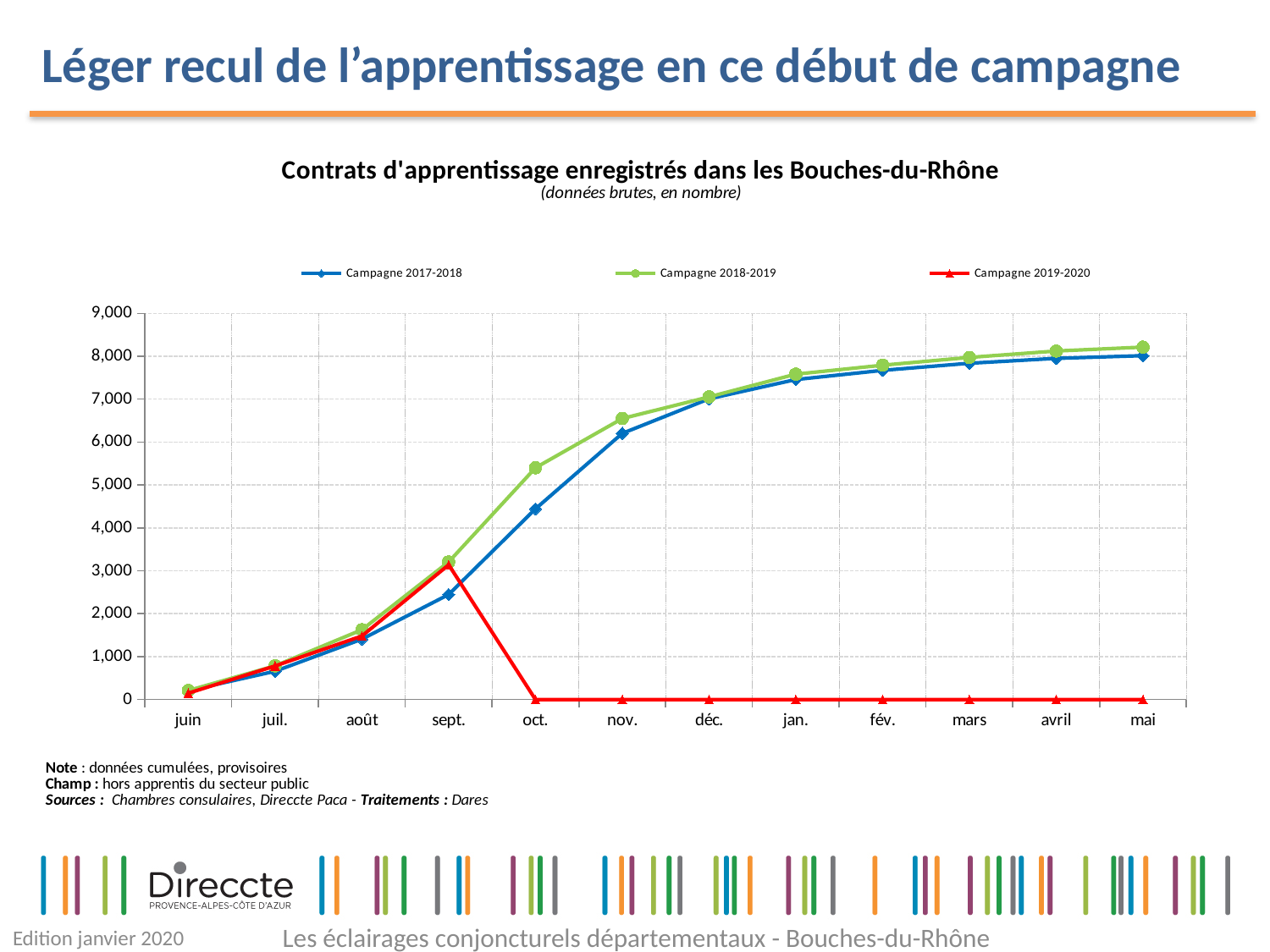
How many series does the legend list? 3 Do the values for Campagne 2017-2018 rise or fall from juin to mai? rise In oct., which series has the higher value, Campagne 2017-2018 or Campagne 2018-2019? Campagne 2018-2019 Is the value for Campagne 2018-2019 in nov. greater or less than 6,000? greater Is the value for Campagne 2018-2019 in mai greater or less than 8,000? greater What is the title of the chart? Contrats d'apprentissage enregistrés dans les Bouches-du-Rhône Is the value for Campagne 2019-2020 in sept. greater or less than 2,000? greater For Campagne 2018-2019, in which month is the value highest? mai How many months are shown on the x axis? 12 In nov., which series has the higher value, Campagne 2017-2018 or Campagne 2018-2019? Campagne 2018-2019 What kind of chart is shown on the slide? line chart